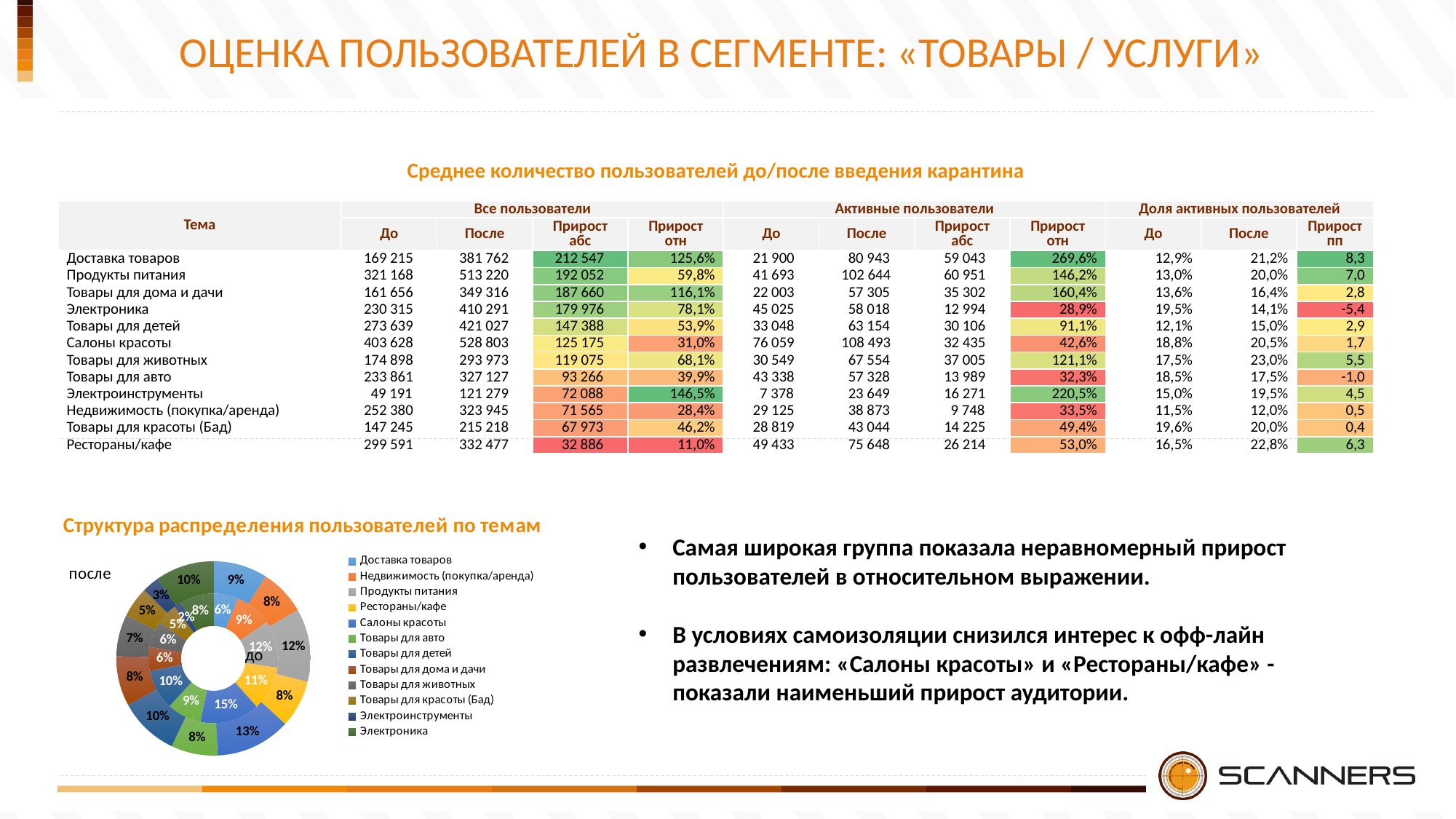
How many categories does the legend of the doughnut chart list? 12 In the doughnut chart, what is the smallest share shown in the inner ring («до»)? 2% What is the title of the doughnut chart on the slide? Структура распределения пользователей по темам In the doughnut chart, what is the share of «Электроника» in the outer ring («после»)? 10% In the doughnut chart, what is the share of «Салоны красоты» in the outer ring («после»)? 13% In the doughnut chart, what is the largest share shown in the inner ring («до»)? 15% In the doughnut chart, which category has the smallest share in the outer ring («после»)? Электроинструменты In the doughnut chart, which is larger in the outer ring («после»): the share of «Продукты питания» or the share of «Товары для животных»? Продукты питания What kind of chart is shown under the title «Структура распределения пользователей по темам»? Doughnut (pie) chart In the doughnut chart, which category has the largest share in the outer ring («после»)? Салоны красоты How many rings (series) does the doughnut chart have? 2 In the doughnut chart, what is the share of «Продукты питания» in the outer ring («после»)? 12%